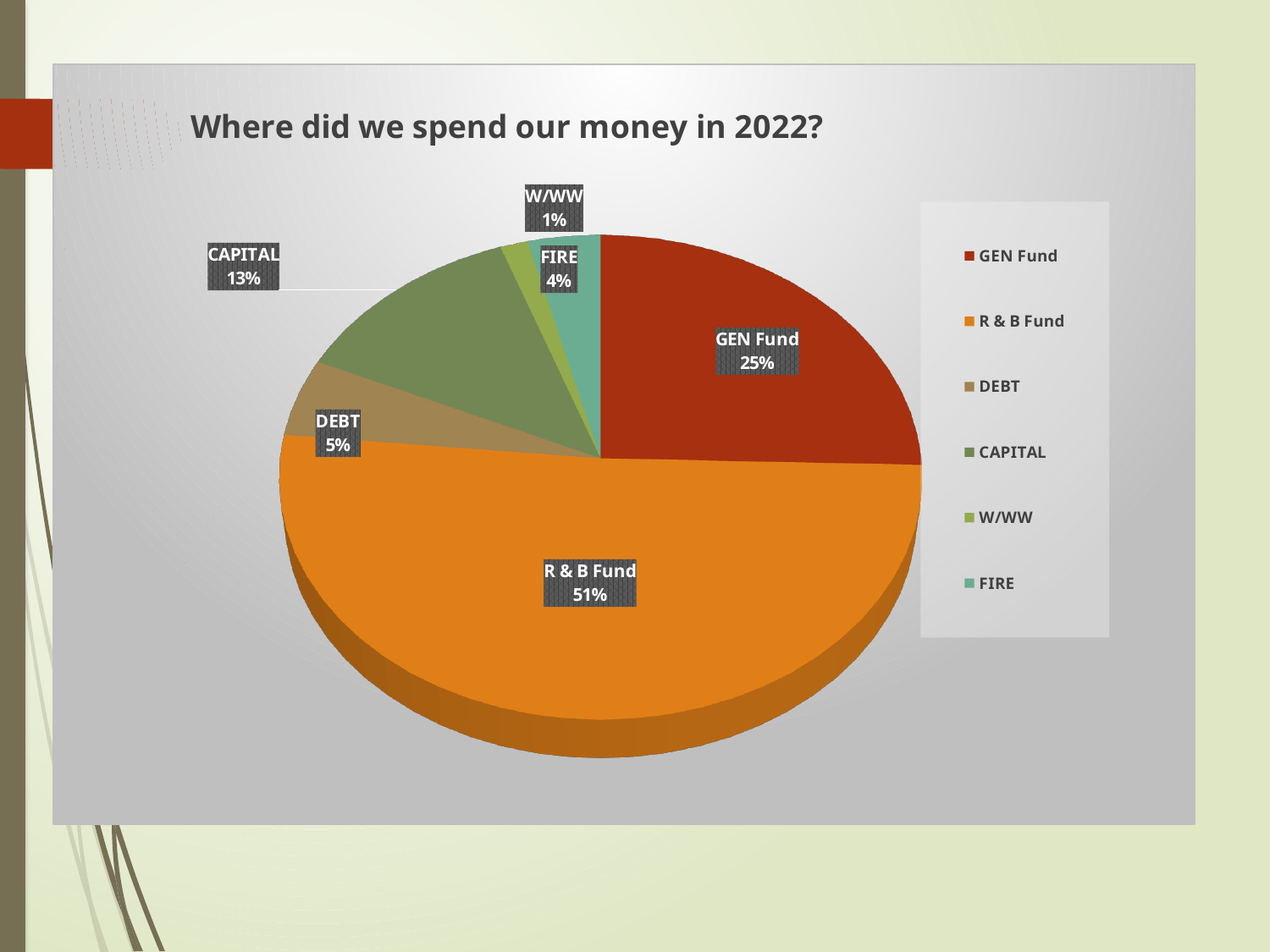
Which category has the largest slice of the pie? R & B Fund What percentage is shown for DEBT? 5% What percentage is shown for the GEN Fund slice? 25% Which category has the smallest slice of the pie? W/WW How many categories are shown in the pie chart? 6 What percentage is shown for CAPITAL? 13% What is the difference in percentage points between the R & B Fund and the GEN Fund? 26 What kind of chart is shown on the slide? Pie chart Which is larger, the CAPITAL slice or the DEBT slice? CAPITAL What percentage is shown for FIRE? 4% What share of spending went to the R & B Fund? 51% What is the title of the chart? Where did we spend our money in 2022?